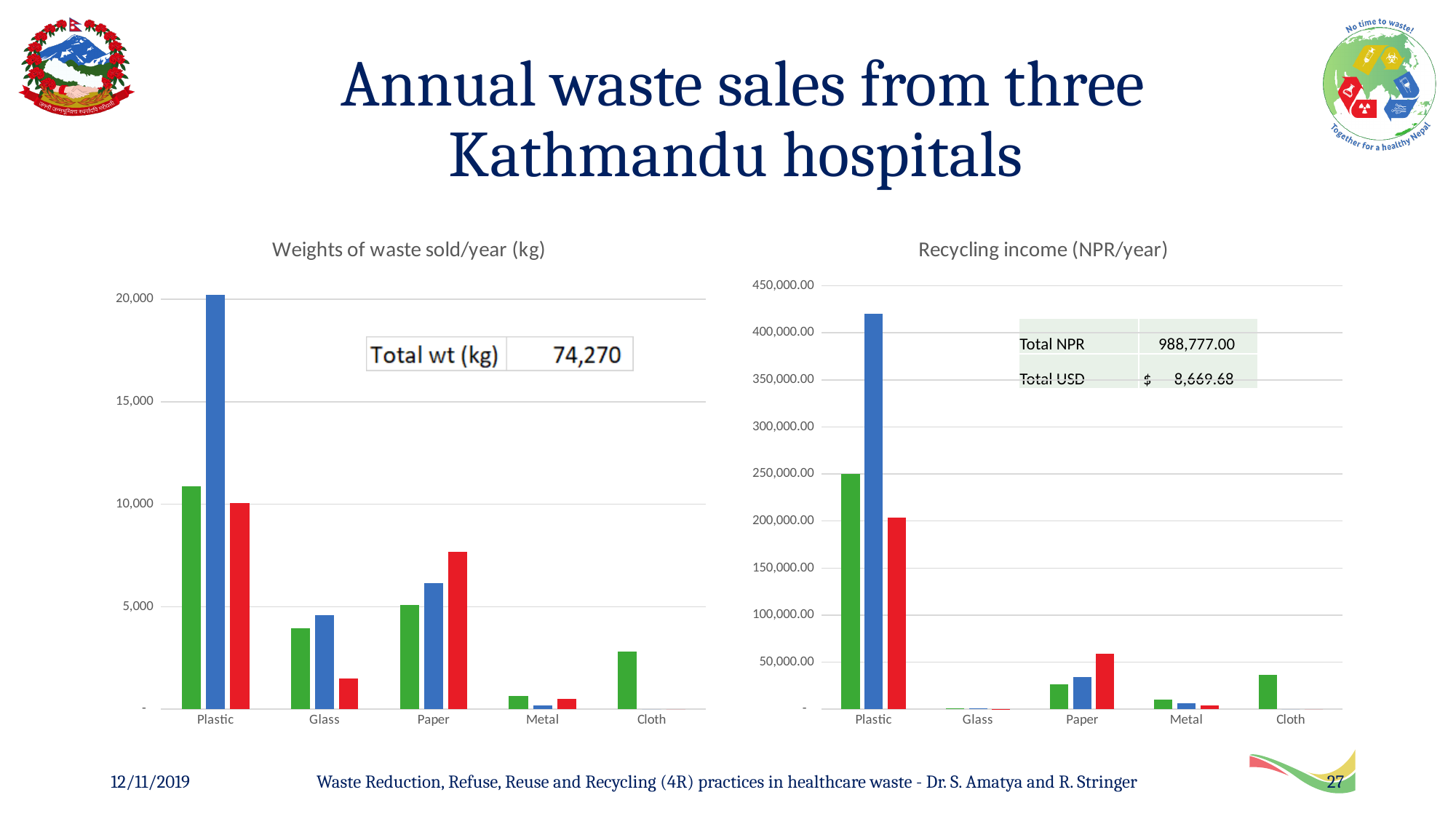
In the 'Recycling income (NPR/year)' chart, for Plastic, is the blue bar or the red bar taller? blue How many categories are shown on the x axis of the 'Recycling income (NPR/year)' chart? 5 In the 'Weights of waste sold/year (kg)' chart, which category has the tallest bar? Plastic In the 'Recycling income (NPR/year)' chart, is the green bar for Cloth greater or less than 50,000.00? less How many bars are plotted for each category in the 'Weights of waste sold/year (kg)' chart? 3 In the 'Weights of waste sold/year (kg)' chart, is the blue bar for Plastic greater or less than 15,000? greater What total weight in kg is shown in the box on the 'Weights of waste sold/year (kg)' chart? 74,270 In the 'Recycling income (NPR/year)' chart, which category has the highest bar? Plastic In the 'Weights of waste sold/year (kg)' chart, for Paper, is the red bar or the green bar taller? red In the 'Weights of waste sold/year (kg)' chart, is the red bar for Glass greater or less than 5,000? less What kind of chart is the 'Weights of waste sold/year (kg)' chart? bar chart